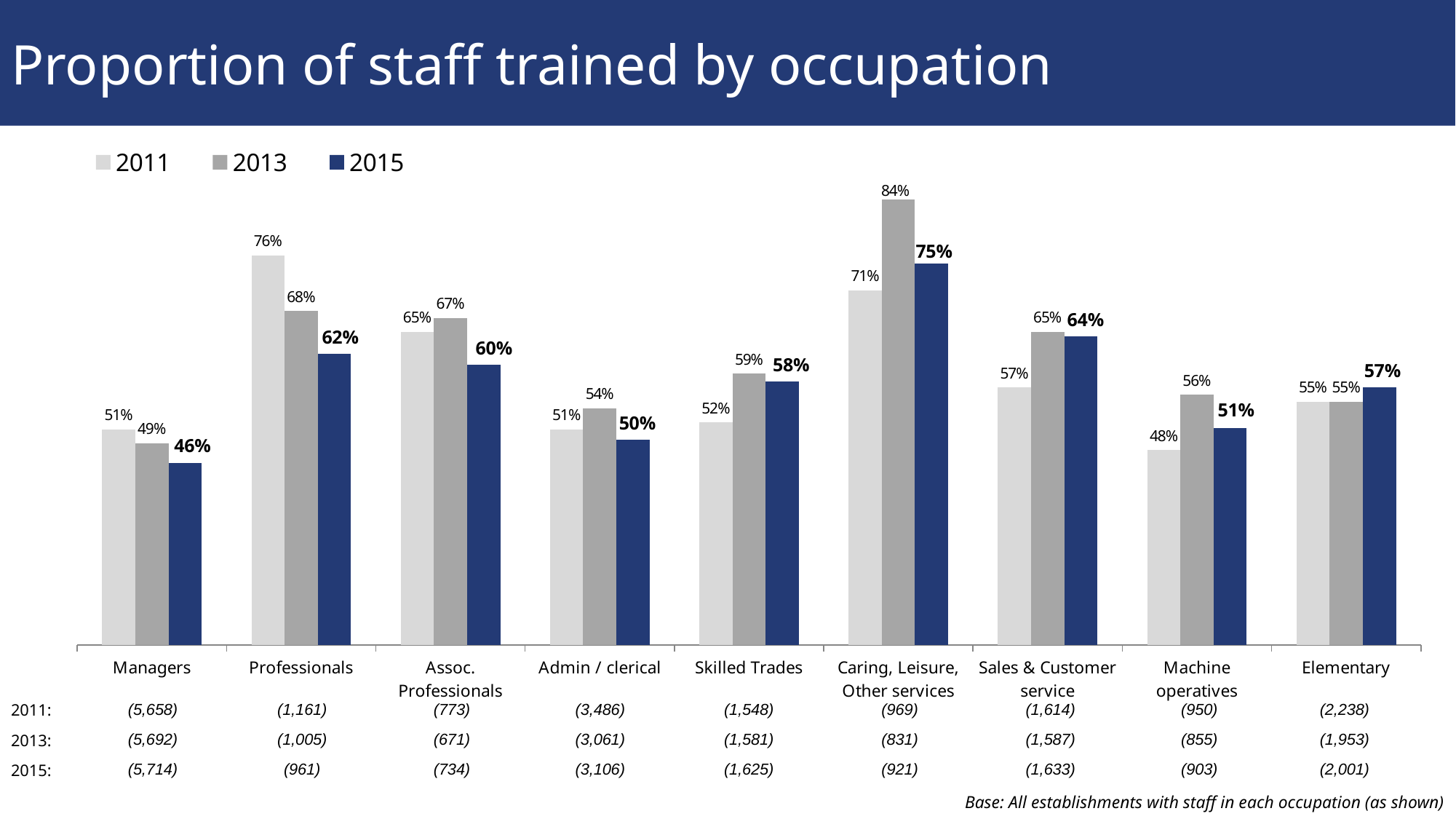
What is the difference between the 2011 and 2015 values for Professionals? 14 percentage points What is the proportion of staff trained for Caring, Leisure, Other services in 2013? 84% Did the proportion of staff trained for Managers rise or fall from 2011 to 2015? Fall What is the title of the chart? Proportion of staff trained by occupation What is the proportion of staff trained for Managers in 2015? 46% Which is larger for Skilled Trades: the 2013 value or the 2015 value? 2013 How many series does the legend list? 3 Which occupation has the lowest proportion of staff trained in 2011? Machine operatives What kind of chart is shown on the slide? Bar chart Which occupation has the highest proportion of staff trained in 2015? Caring, Leisure, Other services How many occupation categories are shown on the x axis? 9 What is the proportion of staff trained for Professionals in 2011? 76%